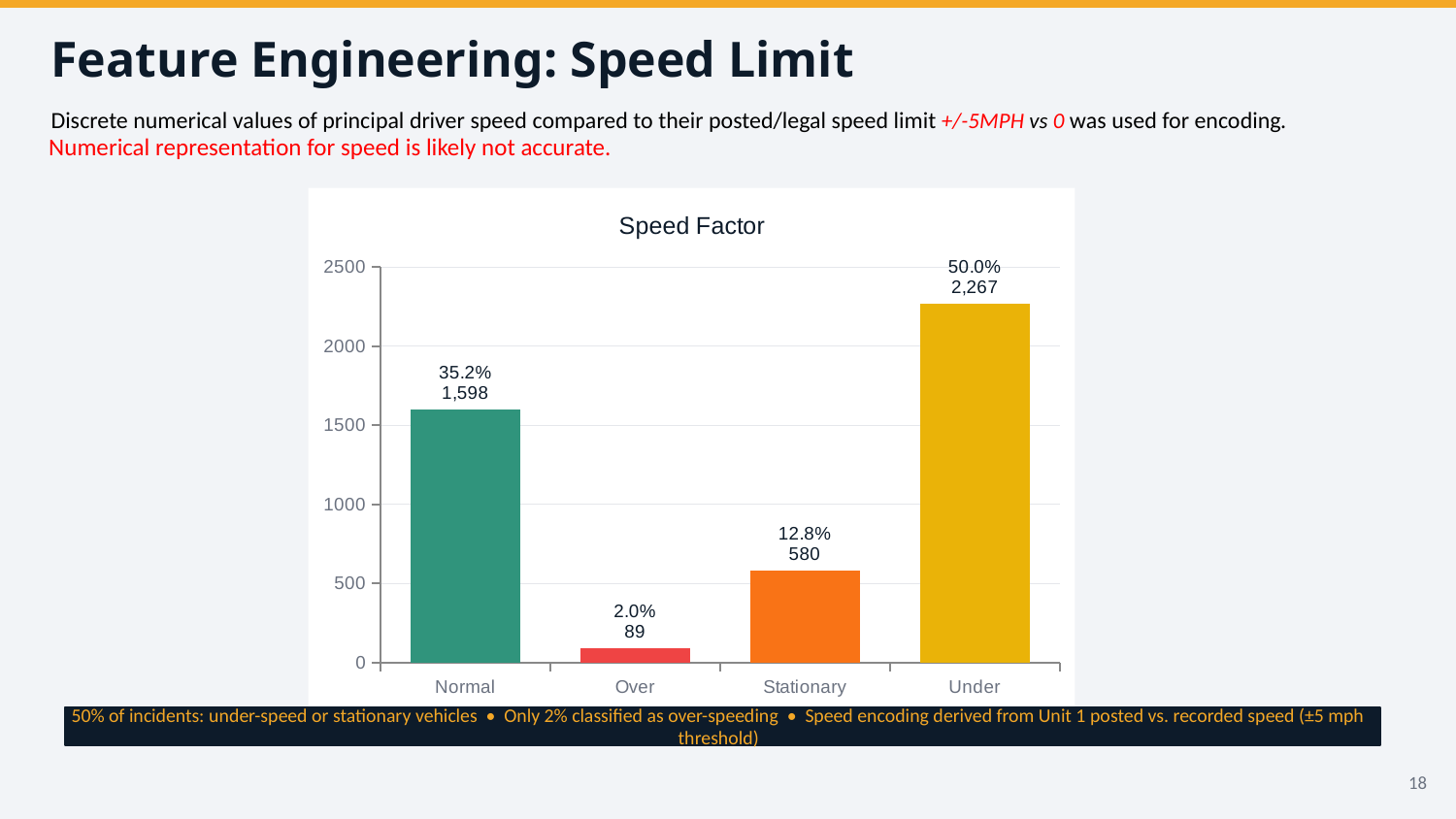
What is the difference between the Under and Normal values? 669 What is the title of the chart? Speed Factor What percentage is shown above the Normal bar? 35.2% Is the value for Normal greater or less than 1500? greater What is the value for the Under category in the Speed Factor chart? 2,267 What kind of chart is shown on the slide? Bar chart How many categories are shown on the x axis? 4 What percentage is shown for the Stationary category? 12.8% Which is larger, the value for Stationary or the value for Over? Stationary What is the count for the Over category? 89 Which category has the highest value? Under Which category has the lowest value? Over